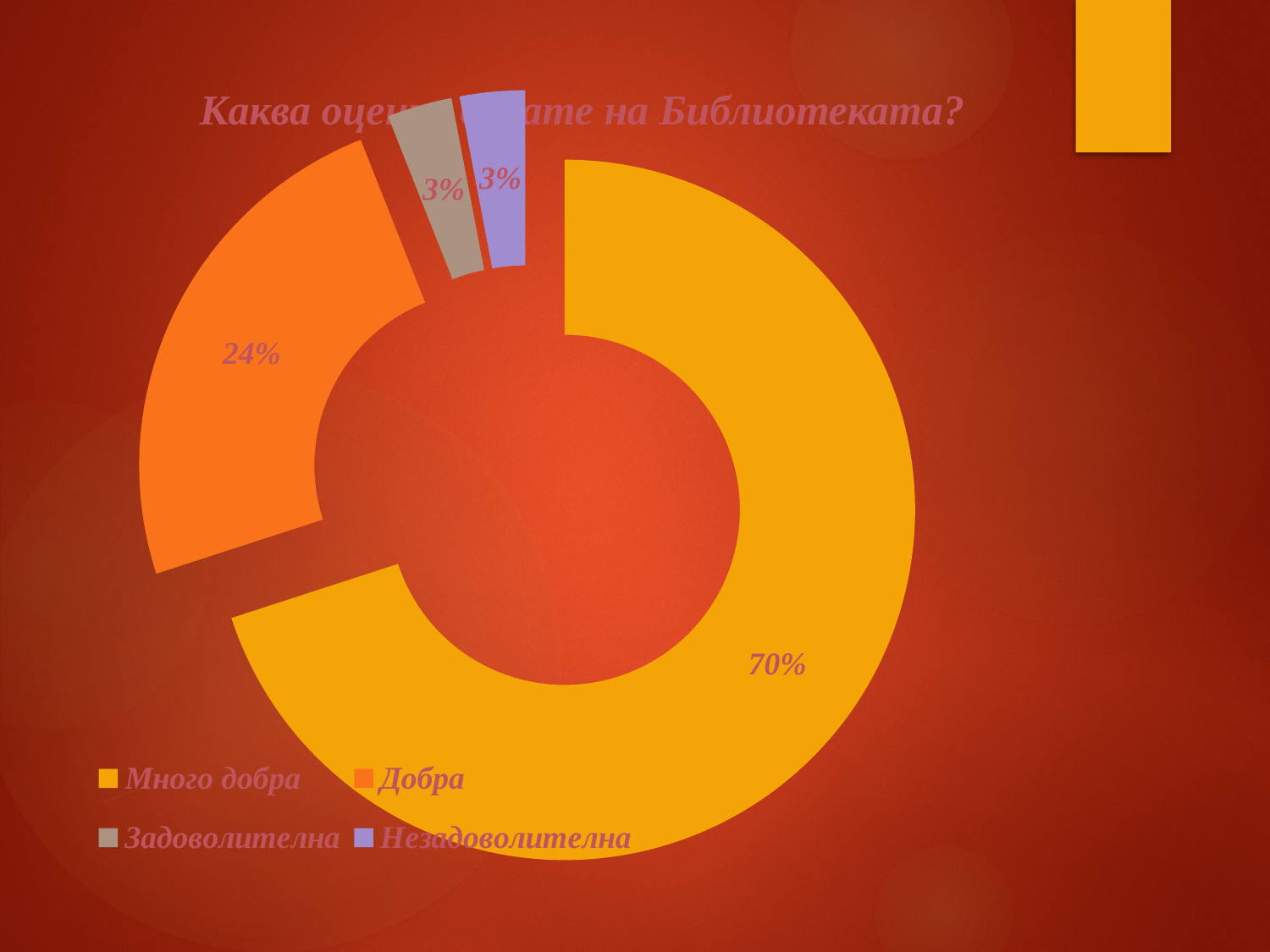
What percentage of the chart is labelled "Незадоволителна"? 3% What colour is the "Незадоволителна" segment? Purple How many categories does the legend list? 4 Which is larger, the share for "Добра" or the share for "Задоволителна"? Добра What is the combined share of "Задоволителна" and "Незадоволителна"? 6% What is the difference in percentage points between "Много добра" and "Добра"? 46 What kind of chart is shown on the slide? Doughnut (pie) chart What percentage of the chart is labelled "Задоволителна"? 3% What percentage of the chart is labelled "Добра"? 24% Which category has the largest share of the chart? Много добра What percentage of the chart is labelled "Много добра"? 70% What colour is the "Добра" segment? Orange